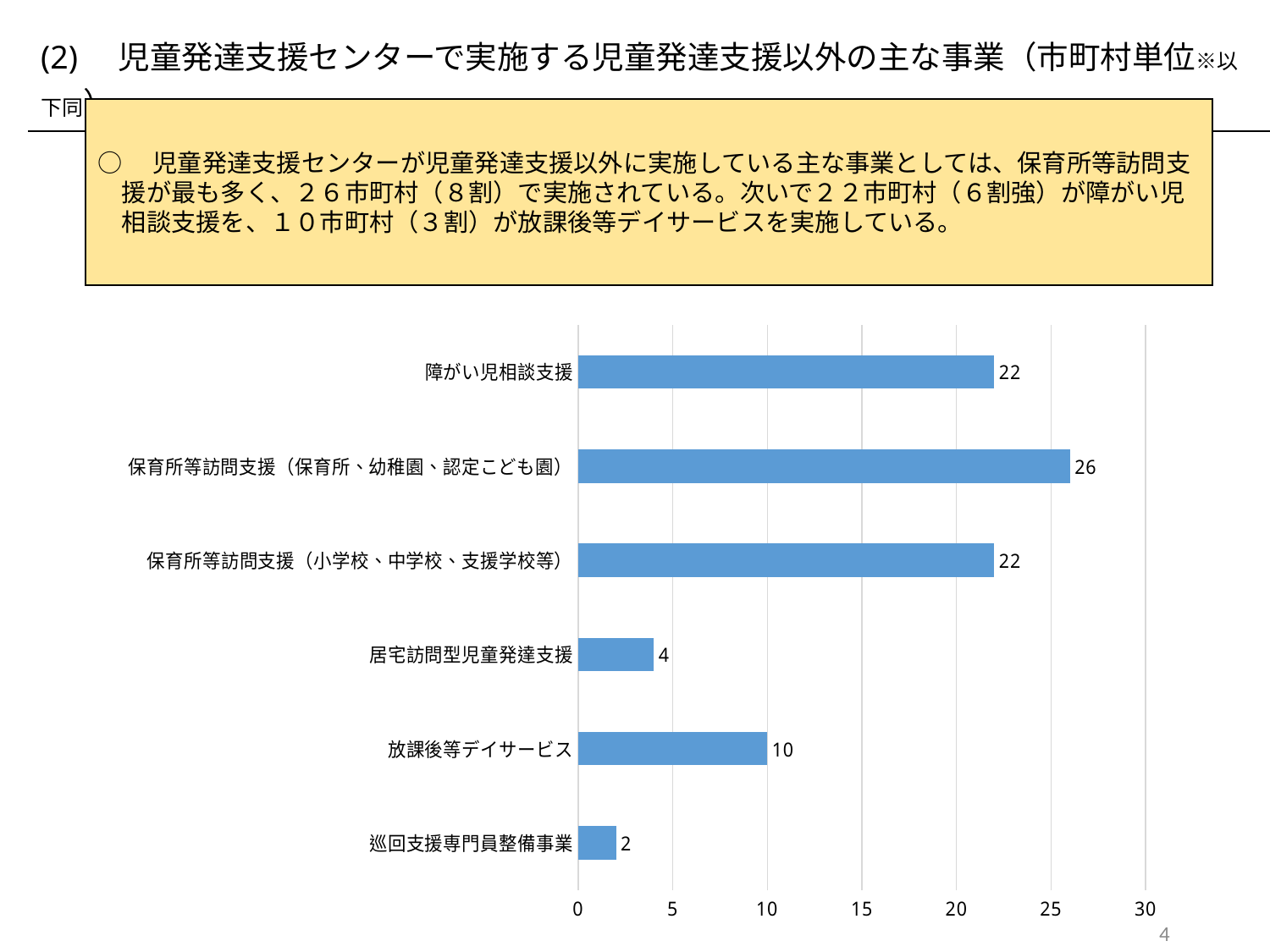
Which is larger, the value for 放課後等デイサービス or the value for 居宅訪問型児童発達支援? 放課後等デイサービス What is the maximum value shown on the horizontal axis? 30 What is the difference between the values for 保育所等訪問支援（保育所、幼稚園、認定こども園） and 放課後等デイサービス? 16 What is the value for 障がい児相談支援? 22 How many categories are shown in the chart? 6 What is the value for 巡回支援専門員整備事業? 2 Which category has the highest value? 保育所等訪問支援（保育所、幼稚園、認定こども園） Which category has the lowest value? 巡回支援専門員整備事業 What is the value for 居宅訪問型児童発達支援? 4 What kind of chart is shown on the slide? Bar chart What is the value for 放課後等デイサービス? 10 What is the value for 保育所等訪問支援（保育所、幼稚園、認定こども園）? 26